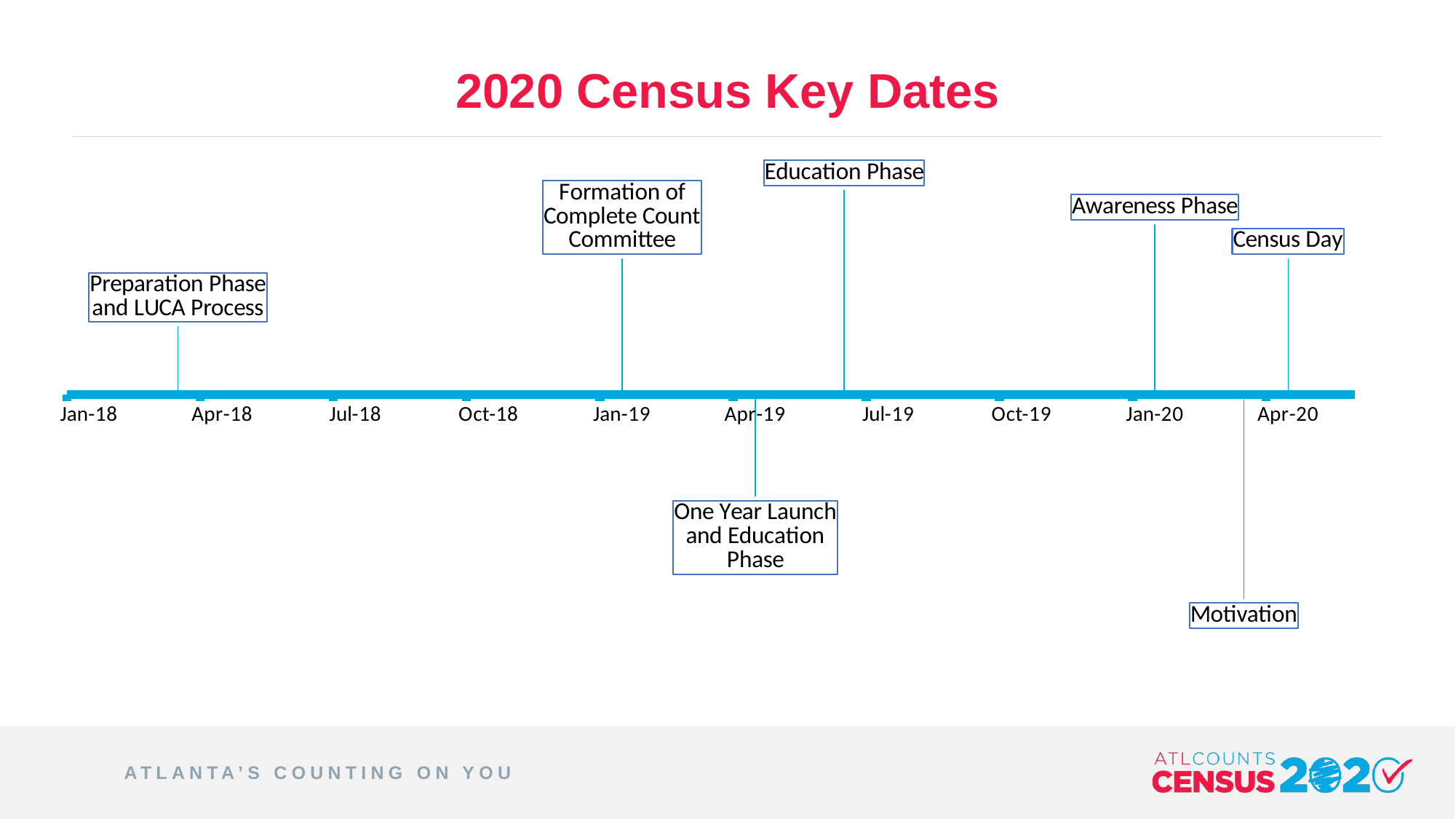
Which event is the latest on the timeline? Census Day Which event is marked at Apr-19 on the timeline? One Year Launch and Education Phase What is the title of the chart? 2020 Census Key Dates Which event is marked at Jan-19 on the timeline? Formation of Complete Count Committee Which event is marked at Apr-20 on the timeline? Census Day How many events are marked on the timeline? 7 Which event is marked at Jan-20 on the timeline? Awareness Phase Does the Motivation event fall before or after Jan-20 on the timeline? After What kind of chart is shown on the slide? Timeline Which comes earlier on the timeline, the Education Phase or the Awareness Phase? Education Phase What is the first date label on the timeline axis? Jan-18 Which event is the earliest on the timeline? Preparation Phase and LUCA Process